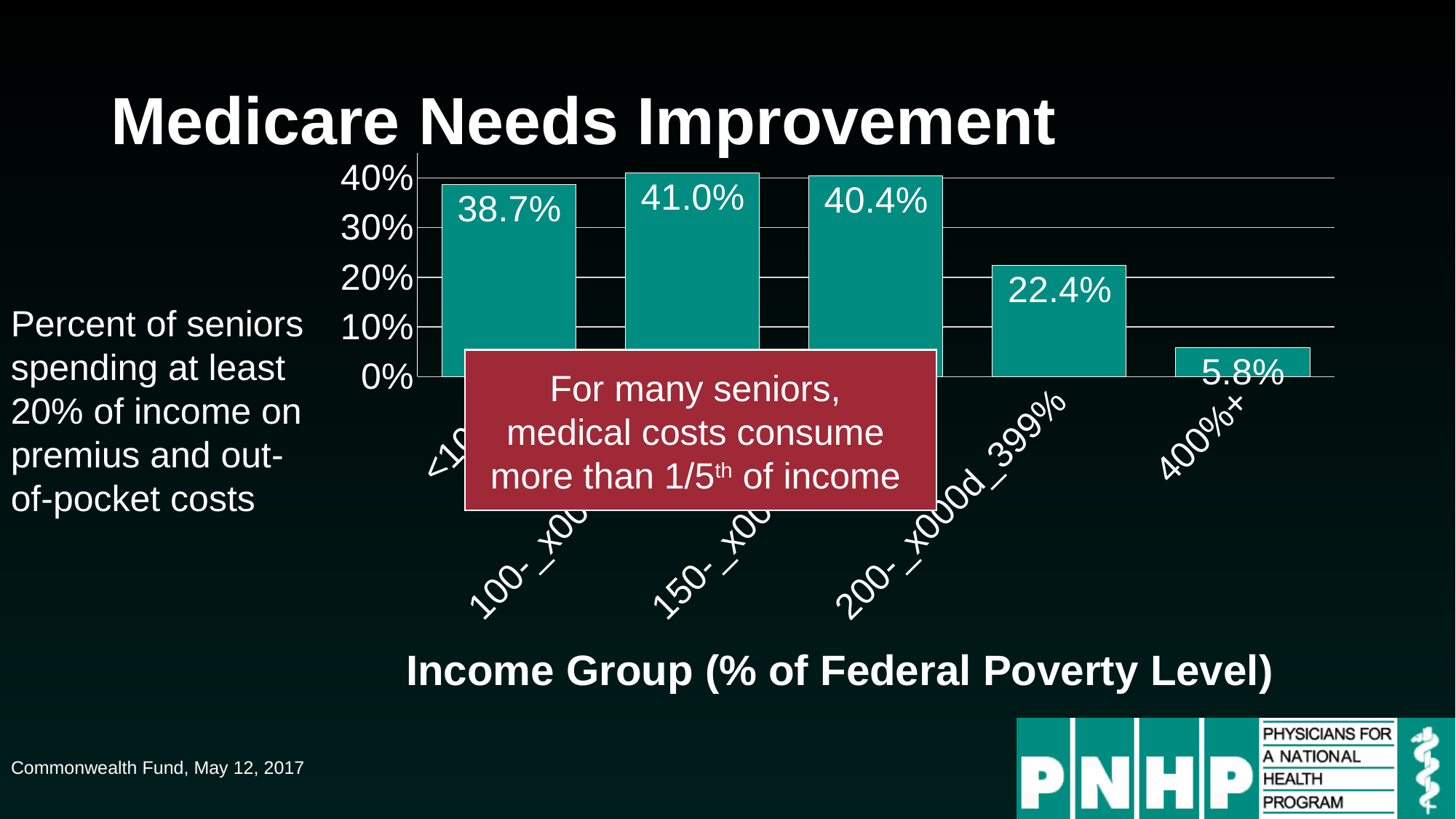
Which income group has the lowest value? 400%+ What kind of chart is shown on the slide? Bar chart What is the value shown on the first (leftmost) bar? 38.7% What is the difference between the highest value (41.0%) and the value for 400%+ (5.8%)? 35.2 percentage points How many bars are plotted on the chart? 5 What is the highest value shown on the chart? 41.0% What is the difference between the third bar (40.4%) and the fourth bar (22.4%)? 18.0 percentage points What is the title of the x axis? Income Group (% of Federal Poverty Level) What is the value shown on the fourth bar from the left? 22.4% What is the value for the 400%+ income group? 5.8% Which is larger, the value on the first bar or the value on the third bar? The third bar (40.4%) Is the value for the 400%+ income group greater or less than 10%? less